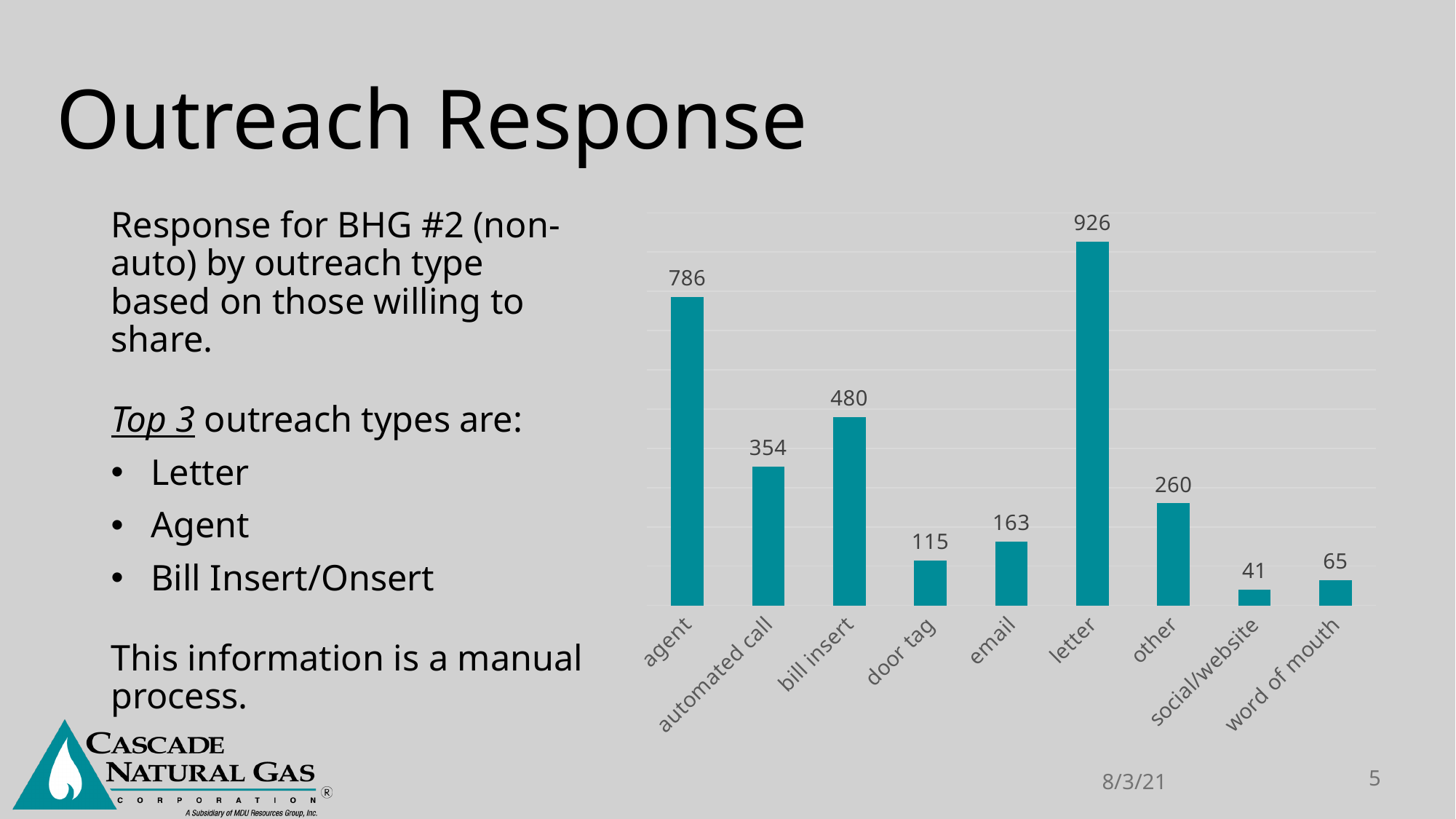
Which outreach type has the highest value? letter What is the difference between the values for letter and agent? 140 How many outreach types are shown on the x axis? 9 What is the value for automated call? 354 What is the value for social/website? 41 Which outreach type has the lowest value? social/website Which is larger, the value for email or the value for word of mouth? email What is the value for letter? 926 What kind of chart is shown on the slide? bar chart What colour are the bars in the chart? teal What is the difference between the values for bill insert and other? 220 What is the value for door tag? 115